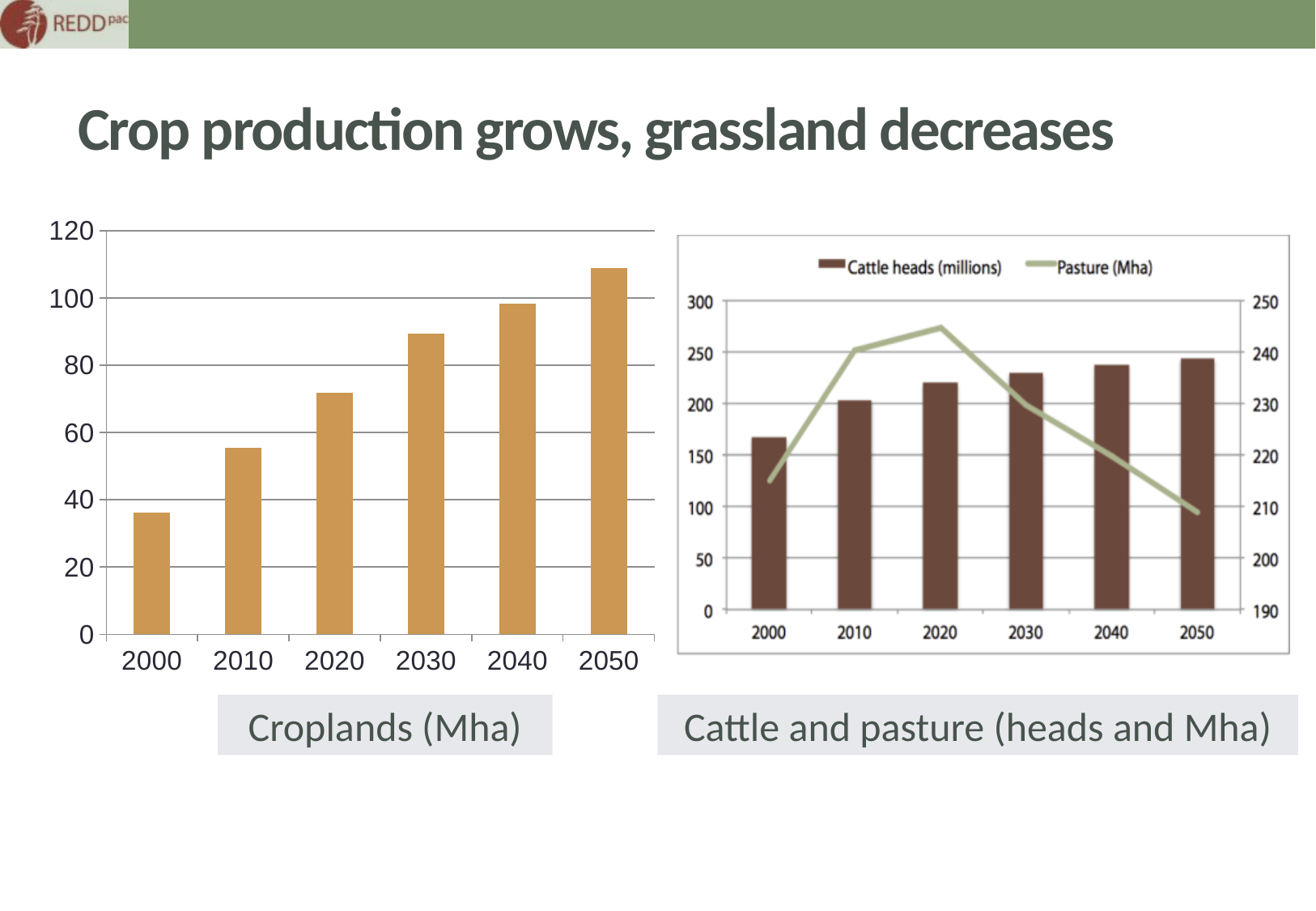
In the Croplands (Mha) chart, is the value for 2050 greater or less than 100? greater In the Croplands (Mha) chart, how many years are shown on the x axis? 6 In the Cattle and pasture chart, in which year does the Pasture (Mha) line reach its highest point? 2020 In the Cattle and pasture chart, how many series does the legend list? 2 In the Croplands (Mha) chart, is the value for 2030 greater or less than 80? greater In the Croplands (Mha) chart, which year has the lowest value? 2000 In the Croplands (Mha) chart, is the value for 2000 greater or less than 40? less In the Croplands (Mha) chart, do the values rise or fall from 2000 to 2050? rise In the Cattle and pasture chart, which series is drawn as a line? Pasture (Mha) What kind of chart is the Croplands (Mha) chart? bar chart In the Croplands (Mha) chart, which year has the highest value? 2050